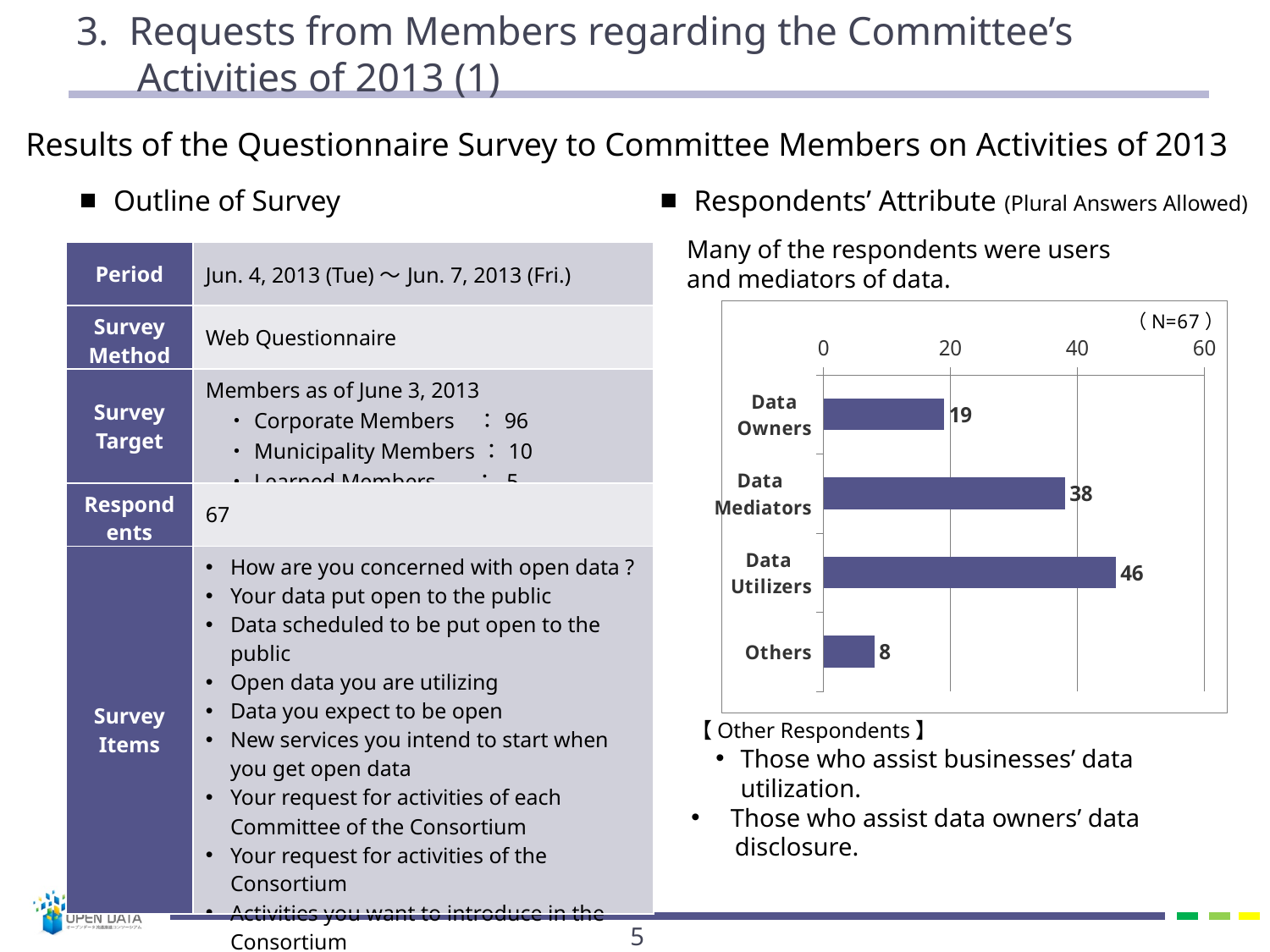
What is the value for Data Utilizers in the Respondents' Attribute chart? 46 How many categories are shown in the Respondents' Attribute chart? 4 What is the difference between the values for Data Utilizers and Data Mediators? 8 What kind of chart is used to show the respondents' attributes? bar chart Which is larger, the value for Data Owners or the value for Others? Data Owners What is the difference between the values for Data Mediators and Data Owners? 19 Which category has the highest value in the Respondents' Attribute chart? Data Utilizers Which category has the lowest value in the Respondents' Attribute chart? Others What is the value for Others in the Respondents' Attribute chart? 8 Is the value for Data Utilizers greater or less than 40? greater What is the value for Data Mediators in the Respondents' Attribute chart? 38 What is the value for Data Owners in the Respondents' Attribute chart? 19